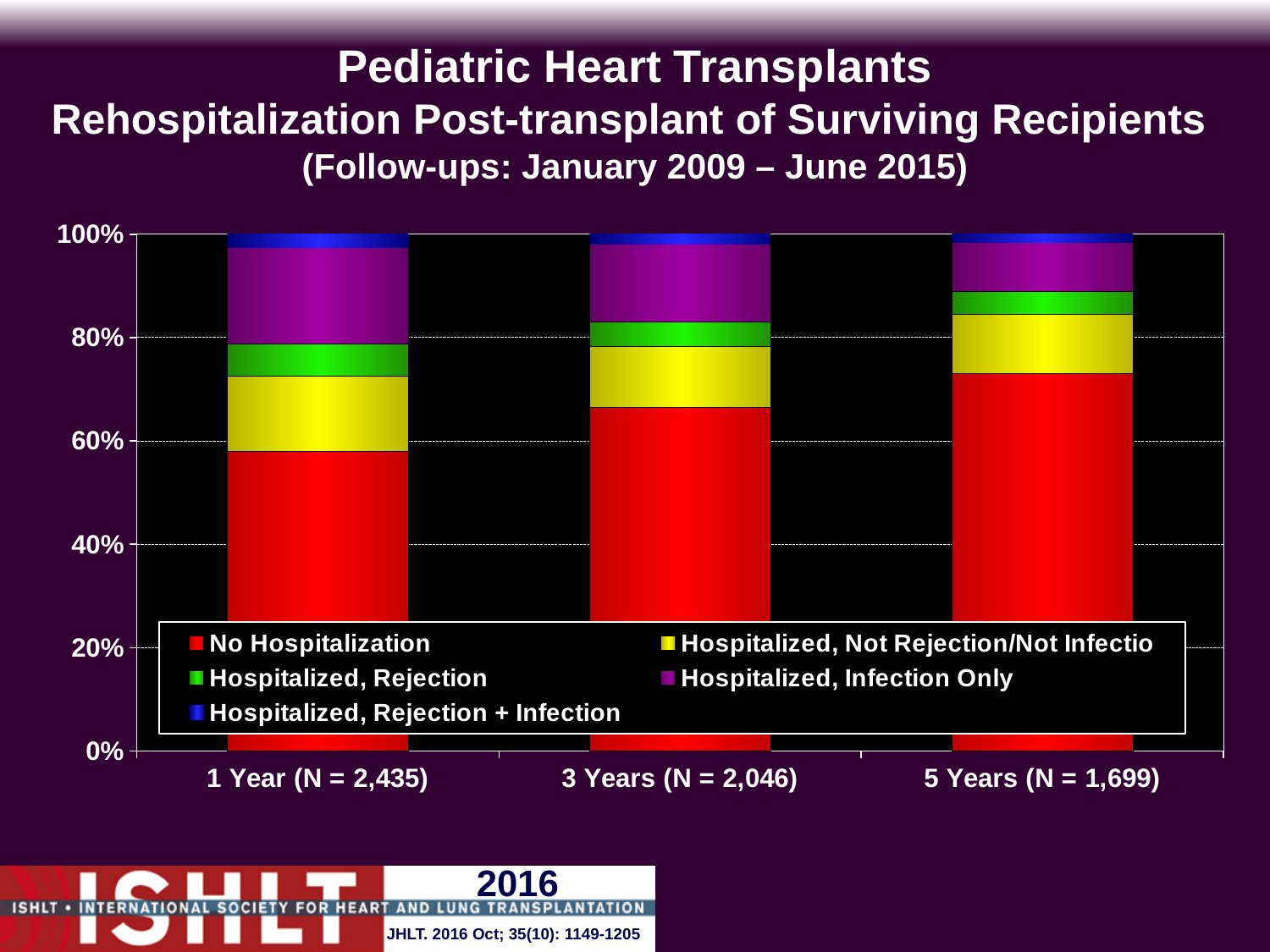
What is the N for the 1 Year category? 2,435 How many series does the legend list? 5 What kind of chart is shown on the slide? Stacked bar chart Does the No Hospitalization share rise or fall from 1 Year to 5 Years? Rise What is the N for the 5 Years category? 1,699 Is the No Hospitalization share at 5 Years greater or less than 80%? less Which colour represents No Hospitalization in the legend? Red Which follow-up category has the largest No Hospitalization share? 5 Years (N = 1,699) Is the Hospitalized, Infection Only share larger at 1 Year or at 5 Years? 1 Year Is the No Hospitalization share at 1 Year greater or less than 60%? less Is the No Hospitalization share at 3 Years greater or less than 60%? greater How many follow-up time categories are shown on the x axis? 3